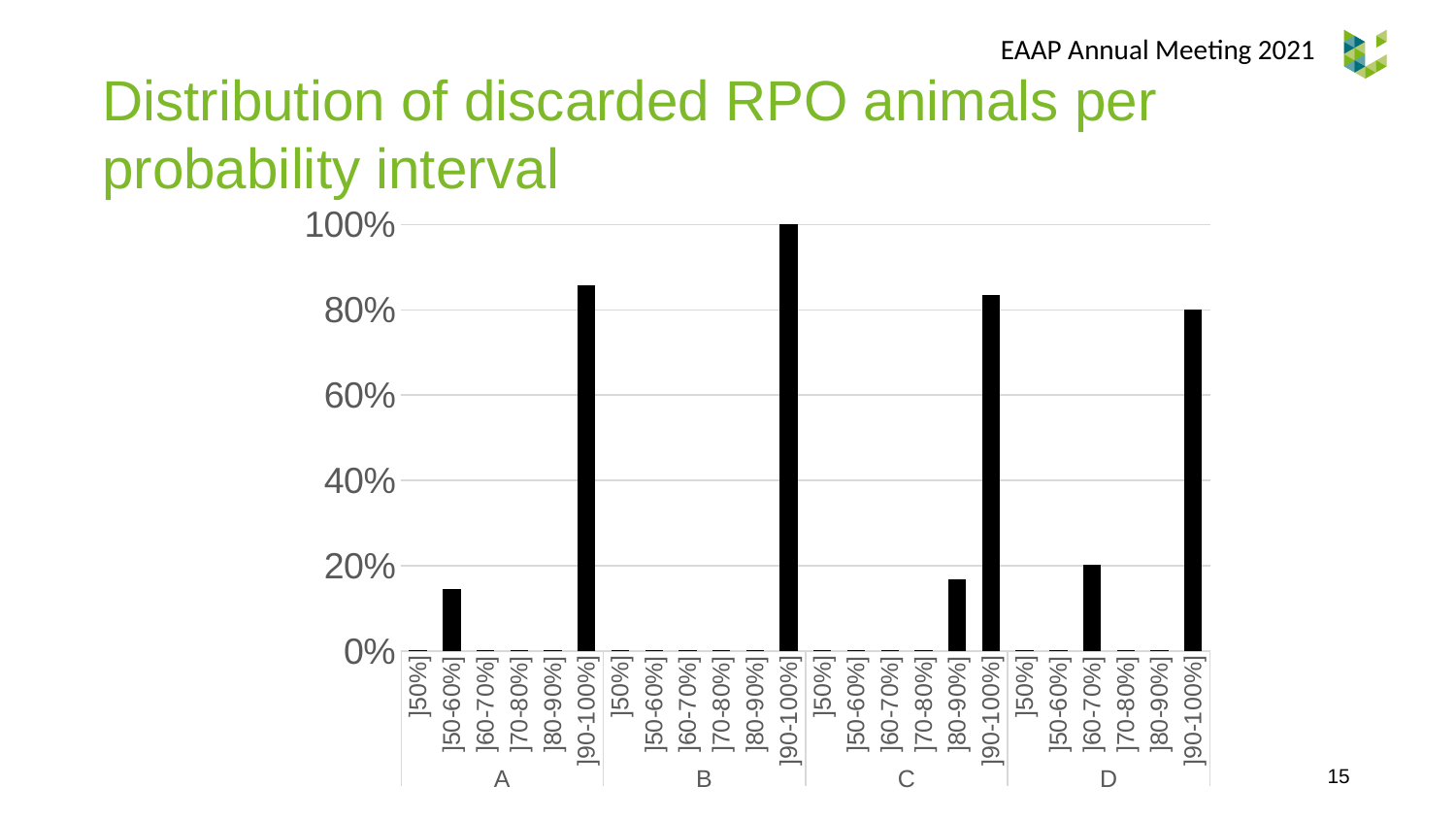
How many probability intervals are listed under each group on the x axis? 6 Is the value for the ]90-100%] interval in group C greater or less than 80%? greater What is the value for the ]90-100%] interval in group B? 100% What is the title of the chart on the slide? Distribution of discarded RPO animals per probability interval In which interval does group B have its only non-zero bar? ]90-100%] Which is larger: the ]90-100%] bar in group A or the ]90-100%] bar in group D? group A Which group and interval has the highest bar in the chart? B, ]90-100%] Is the value for the ]90-100%] interval in group A greater or less than 80%? greater How many groups (A, B, C, D) are shown along the x axis of the chart? 4 Is the value for the ]80-90%] interval in group C greater or less than 20%? less What kind of chart is shown on the slide? bar chart